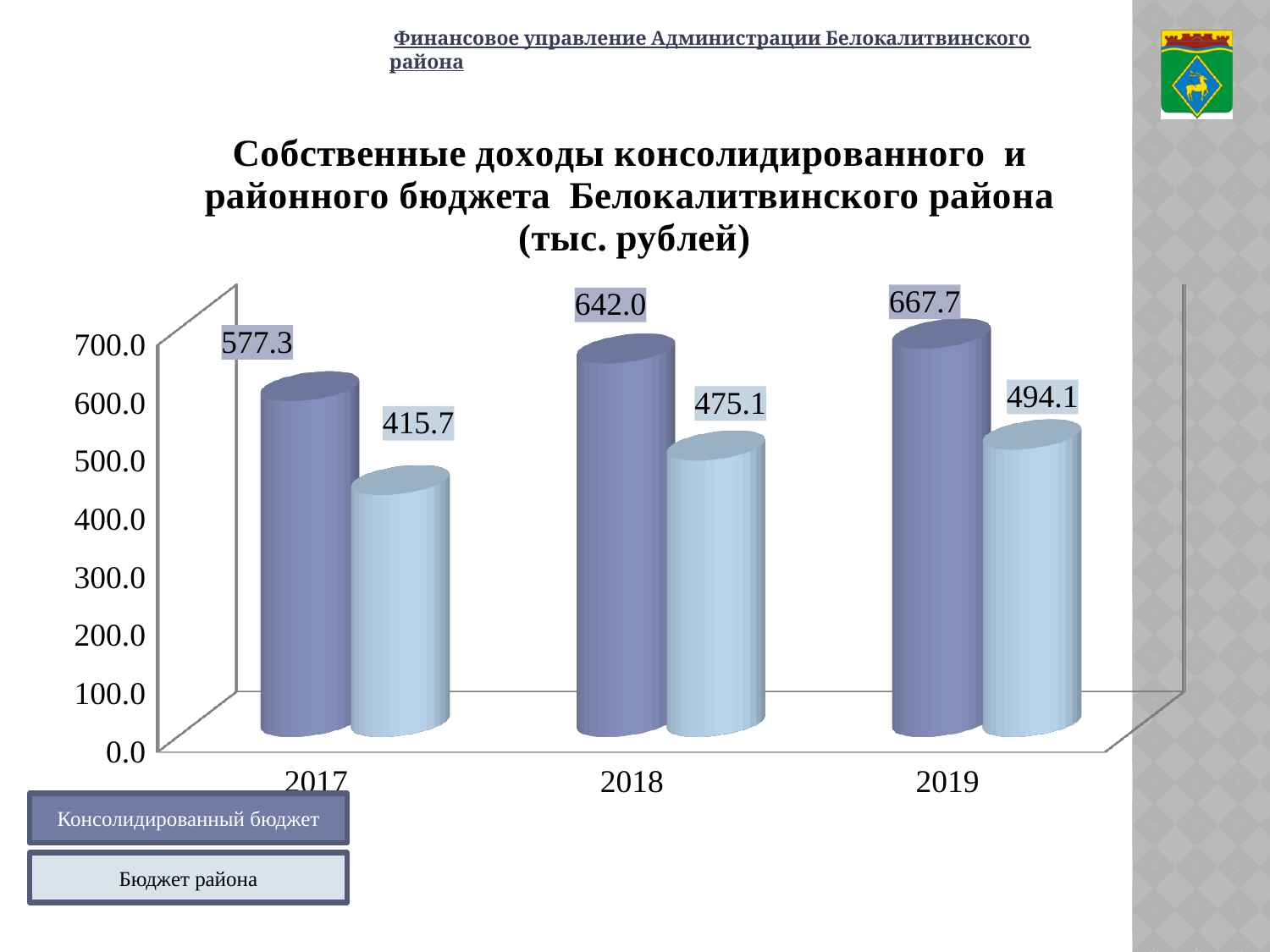
What is the difference between Консолидированный бюджет and Бюджет района in 2019? 173.6 What is the value for Бюджет района in 2019? 494.1 In which year is the Бюджет района value lowest? 2017 In which year is the Консолидированный бюджет value highest? 2019 How many years are shown on the x axis? 3 What kind of chart is shown on the slide? Bar chart What is the difference between the Консолидированный бюджет values for 2018 and 2017? 64.7 What is the value for Консолидированный бюджет in 2018? 642.0 Do the Бюджет района values rise or fall from 2017 to 2019? Rise Which is larger: Бюджет района in 2018 or Консолидированный бюджет in 2017? Консолидированный бюджет in 2017 What is the value for Бюджет района in 2017? 415.7 How many series does the legend list? 2